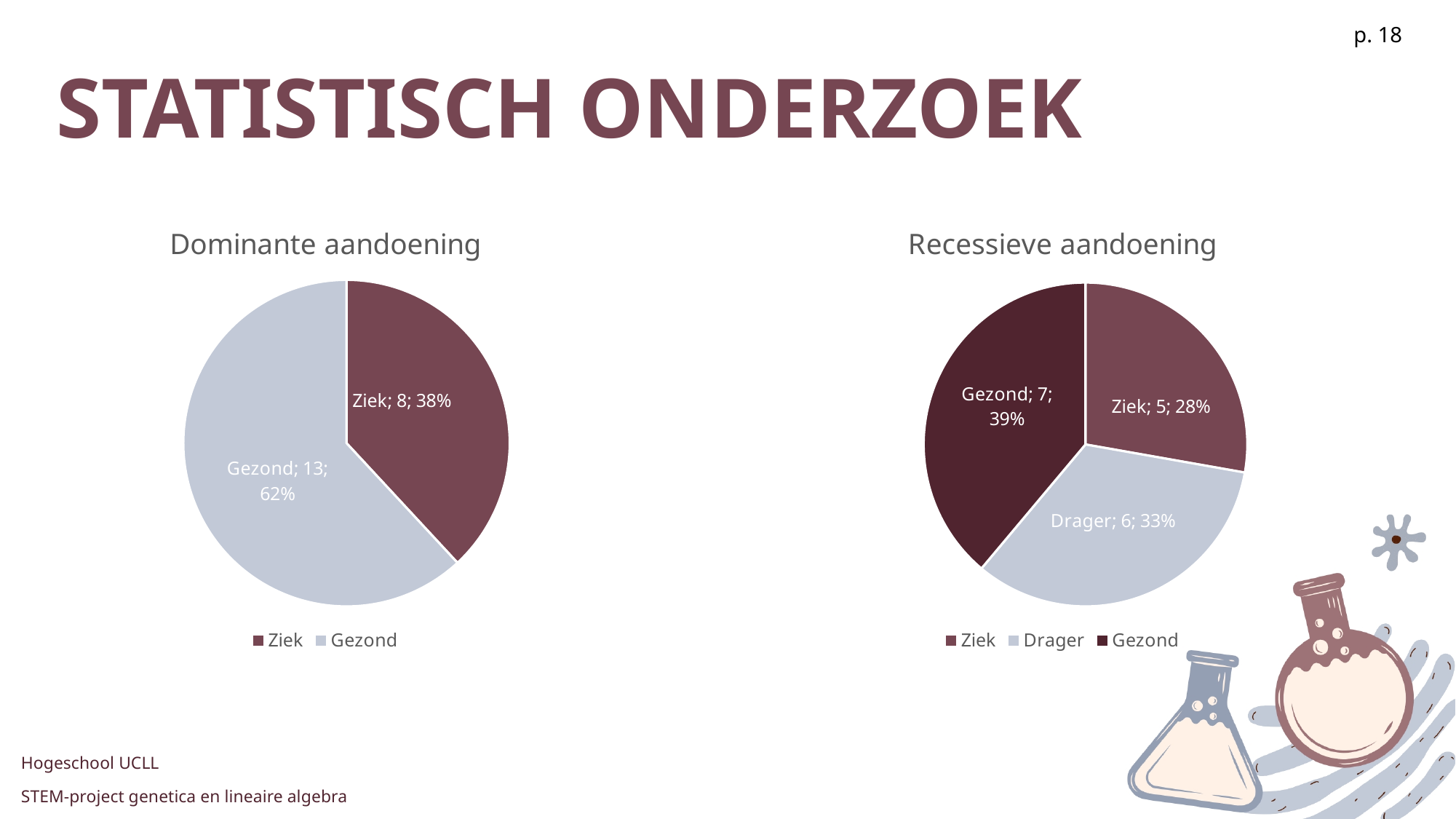
In the 'Dominante aandoening' chart, how many categories are shown? 2 In the 'Recessieve aandoening' chart, which category is the smallest? Ziek In the 'Recessieve aandoening' chart, which is larger, Gezond or Drager? Gezond What is the title of the chart on the left of the slide? Dominante aandoening In the 'Dominante aandoening' chart, which category is the largest? Gezond What kind of chart is the 'Recessieve aandoening' chart? Pie chart In the 'Recessieve aandoening' chart, how many categories does the legend list? 3 In the 'Dominante aandoening' chart, what is the value for Ziek? 8 In the 'Dominante aandoening' chart, what share of the pie is Gezond? 62% In the 'Dominante aandoening' chart, what is the difference between the Gezond and Ziek values? 5 In the 'Recessieve aandoening' chart, what is the value for Drager? 6 In the 'Recessieve aandoening' chart, what share of the pie is Ziek? 28%